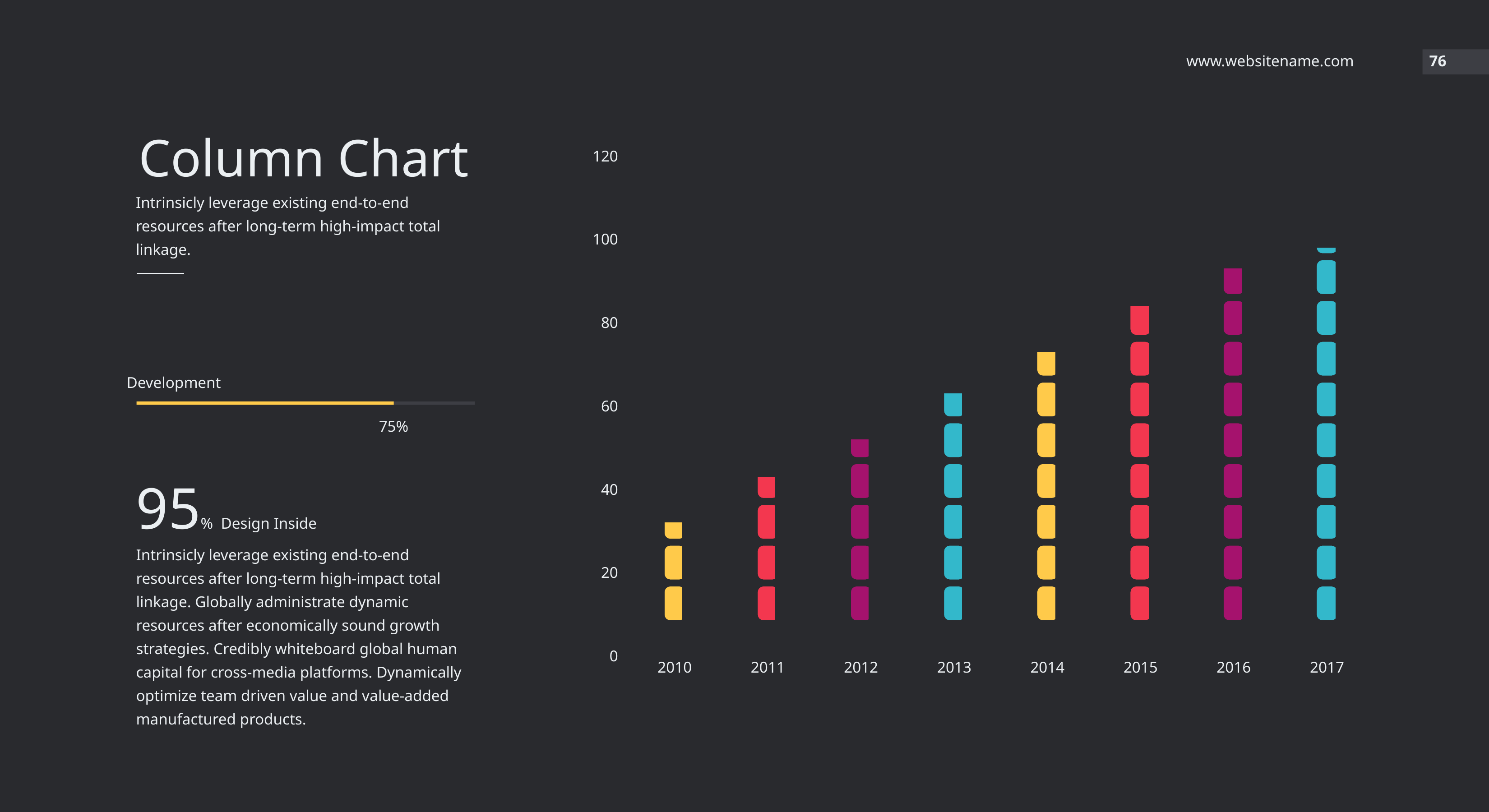
Which year has the lowest value in the chart? 2010 Do the values rise or fall from 2010 to 2017? rise Which is larger, the value for 2014 or the value for 2011? 2014 What is the title of the slide containing the chart? Column Chart Is the value for 2012 greater or less than 60? less What is the highest value labelled on the vertical axis of the chart? 120 Is the value for 2013 greater or less than 60? greater Is the value for 2015 greater or less than 80? greater How many years are shown on the x axis of the chart? 8 What kind of chart is shown on the slide? bar chart Which year has the highest value in the chart? 2017